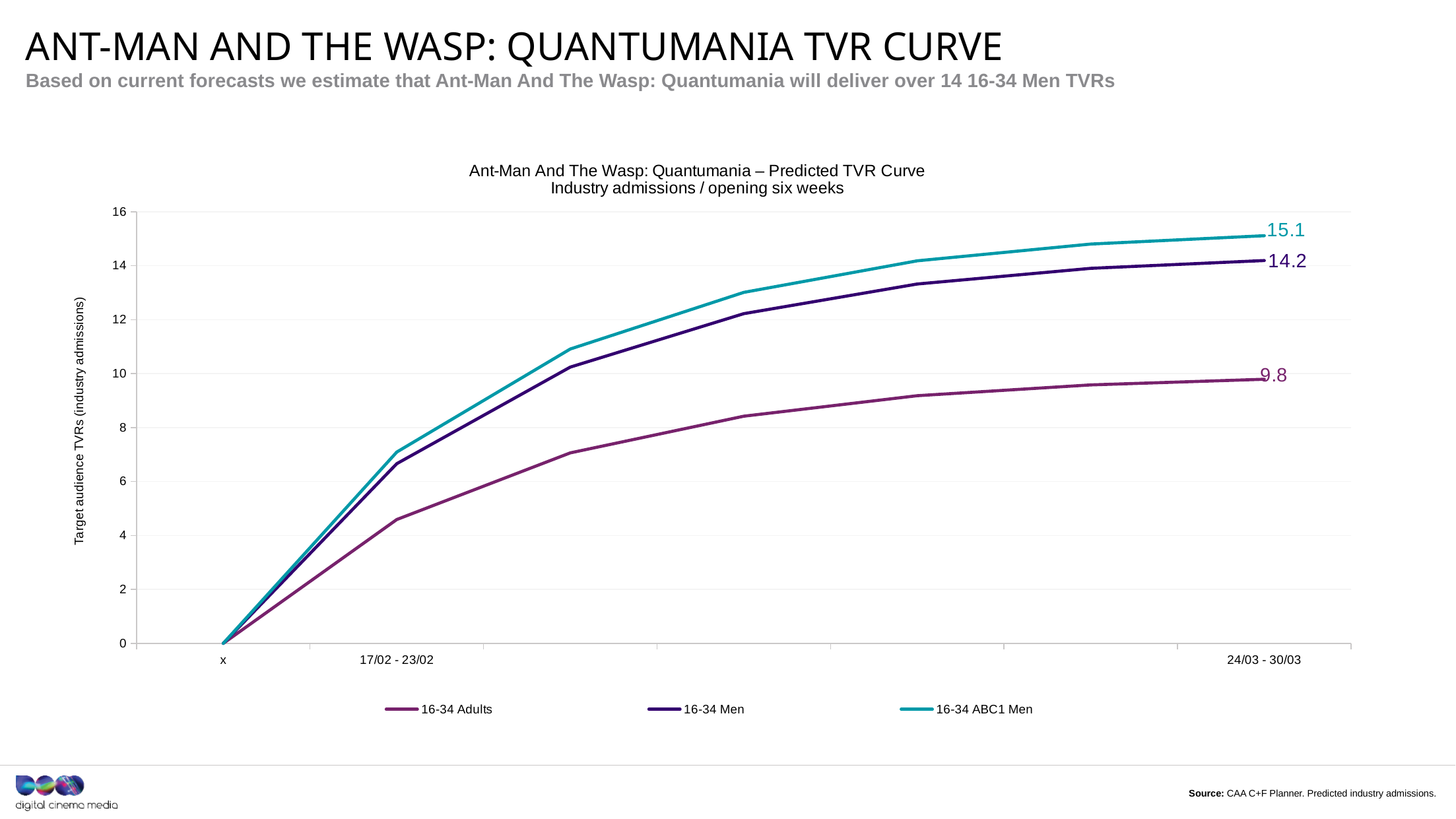
Which series has the lowest value at 24/03 - 30/03? 16-34 Adults What kind of chart is shown on the slide? Line chart What is the final value for 16-34 Adults at 24/03 - 30/03? 9.8 What is the final value for 16-34 ABC1 Men at 24/03 - 30/03? 15.1 Which series reaches the highest value at 24/03 - 30/03? 16-34 ABC1 Men Which is larger at 24/03 - 30/03: 16-34 Men or 16-34 Adults? 16-34 Men What is the difference between the final values of 16-34 ABC1 Men and 16-34 Adults? 5.3 What is the final value for 16-34 Men at 24/03 - 30/03? 14.2 How many series does the legend list? 3 Is the value for 16-34 Adults at 17/02 - 23/02 greater or less than 6? less Is the value for 16-34 ABC1 Men at 17/02 - 23/02 greater or less than 6? greater What is the difference between the final values of 16-34 Men and 16-34 Adults? 4.4